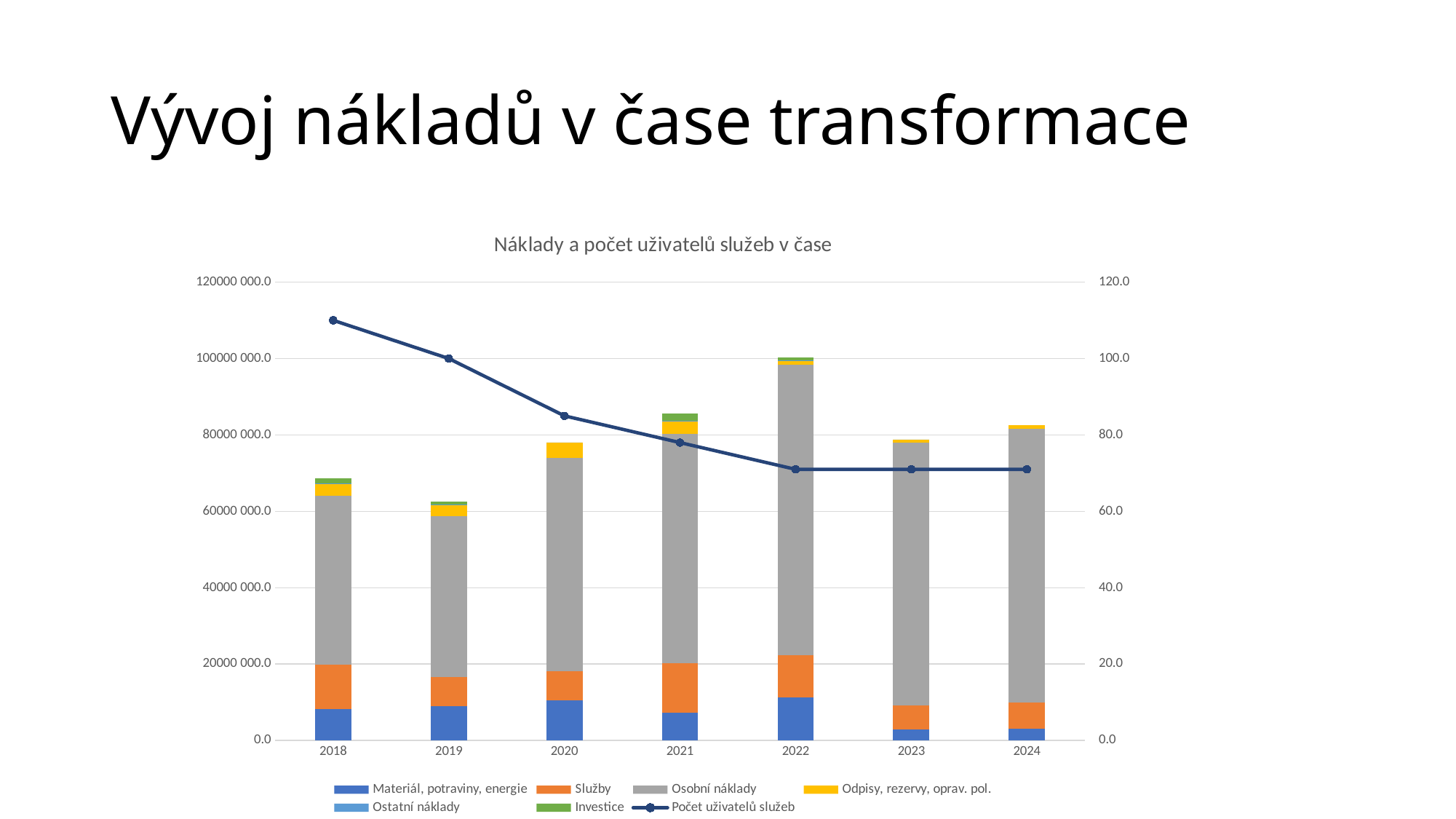
What kind of chart is shown on the slide? Stacked bar chart combined with a line chart Is the total stacked bar for 2019 greater or less than 80000 000.0? less Does the Počet uživatelů služeb line rise or fall from 2018 to 2022? fall Is the value of Počet uživatelů služeb for 2018 greater or less than 100.0? greater What is the title of the chart? Náklady a počet uživatelů služeb v čase Is the value of Počet uživatelů služeb for 2022 greater or less than 80.0? less How many years are shown on the x axis of the chart? 7 How many series does the chart's legend list? 7 Which year has the lowest total stacked bar? 2019 Which year has the highest total stacked bar? 2022 Which colour represents Osobní náklady in the chart? Grey Is the total stacked bar for 2022 larger or smaller than the total for 2019? larger